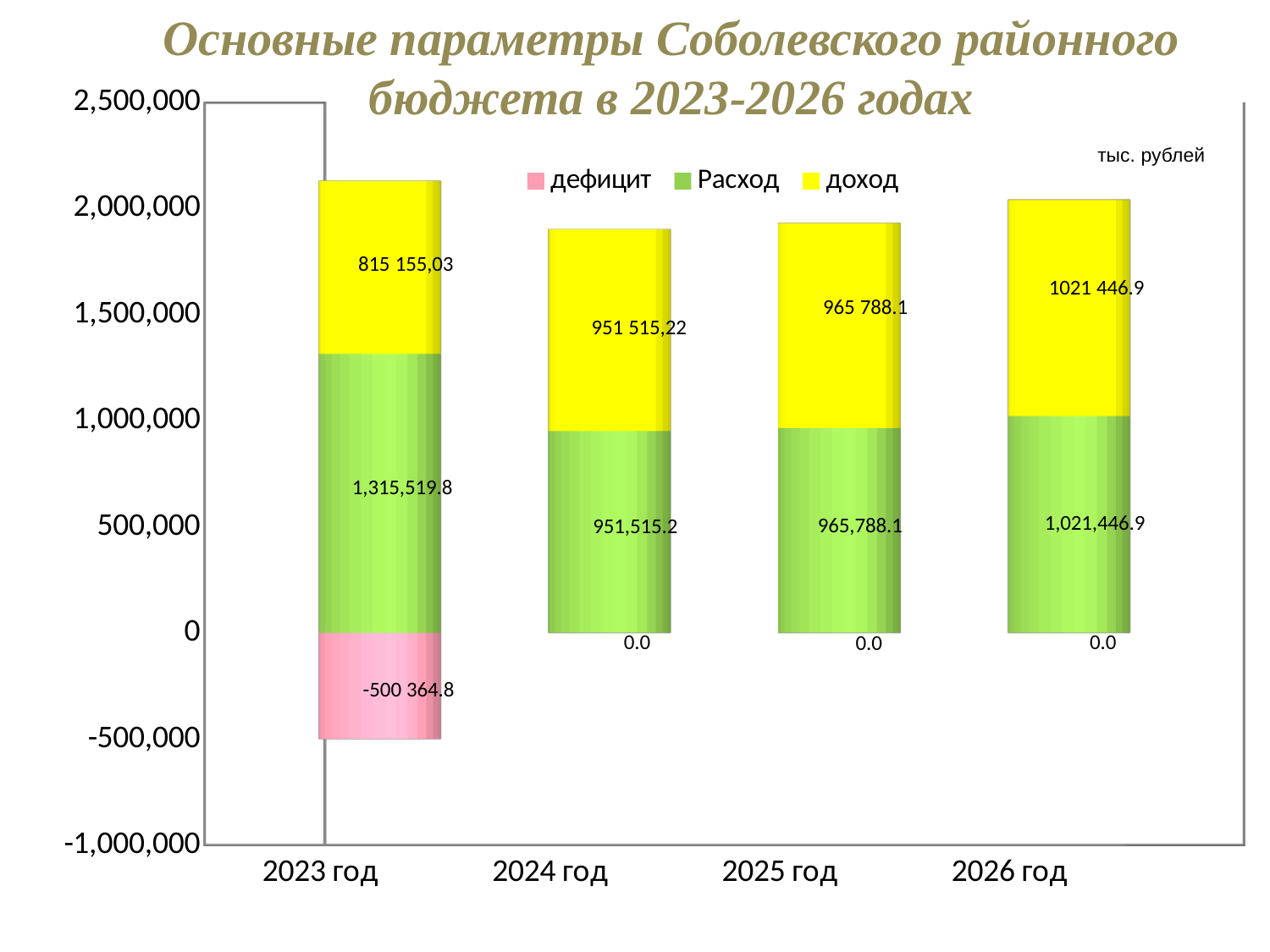
What kind of chart is shown on the slide? Stacked bar chart Which year has the lowest value for доход? 2023 год What is the value of доход for 2026 год? 1021 446.9 Which year has the highest value for Расход? 2023 год What is the value of Расход for 2023 год? 1,315,519.8 How many series does the legend list? 3 What is the difference between Расход for 2026 год and Расход for 2025 год? 55,658.8 How many years are shown on the x axis? 4 What is the value of дефицит for 2025 год? 0.0 Which is larger, Расход for 2025 год or Расход for 2026 год? 2026 год What is the value of доход for 2024 год? 951 515,22 What is the value of дефицит for 2023 год? -500 364.8